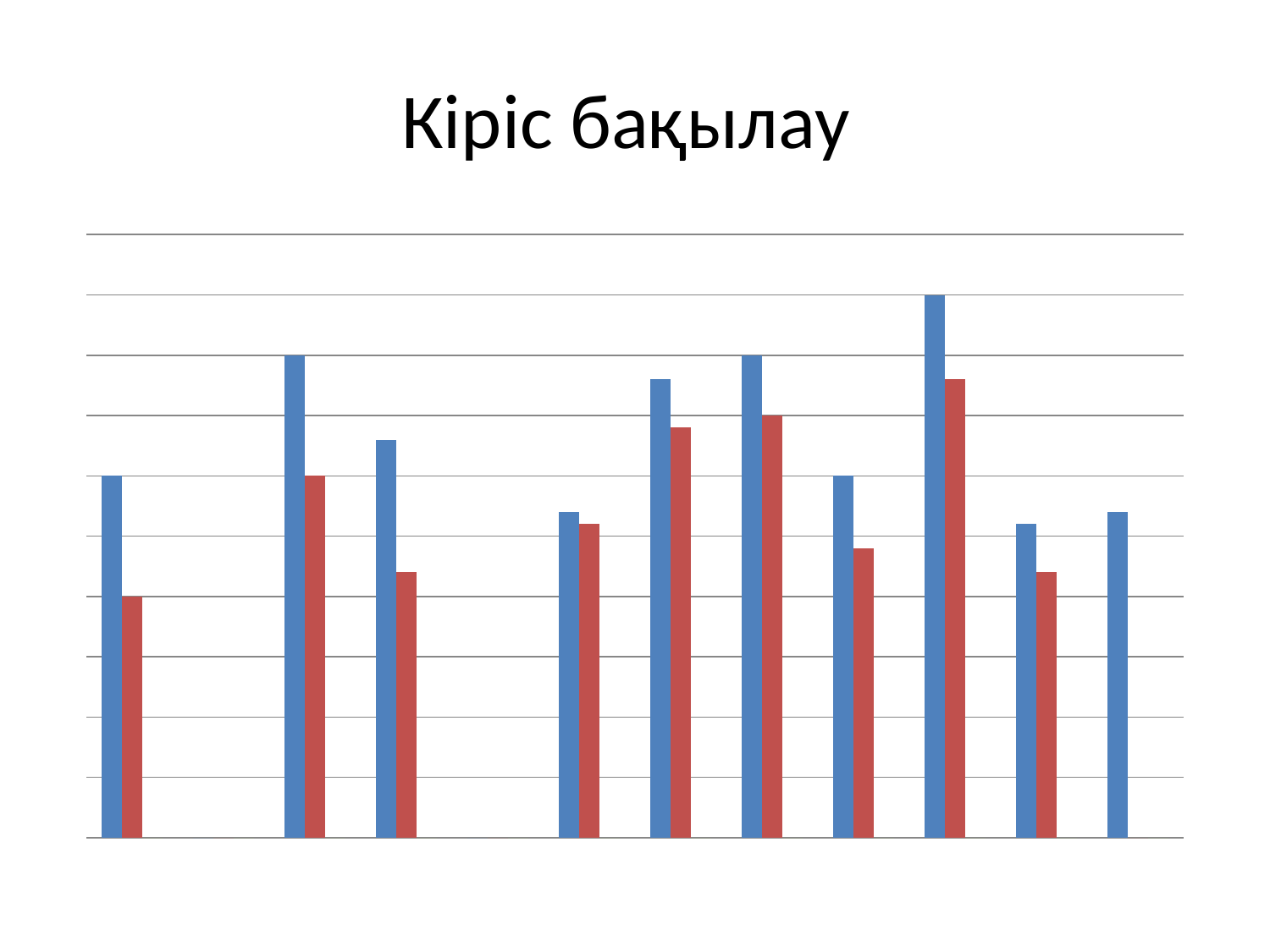
What two colours are used for the bars in the chart? blue and red What is the title of the chart? Кіріс бақылау In each pair of bars, is the blue bar or the red bar taller? blue Which colour of bar reaches the highest point on the chart, blue or red? blue What kind of chart is shown on the slide? bar chart